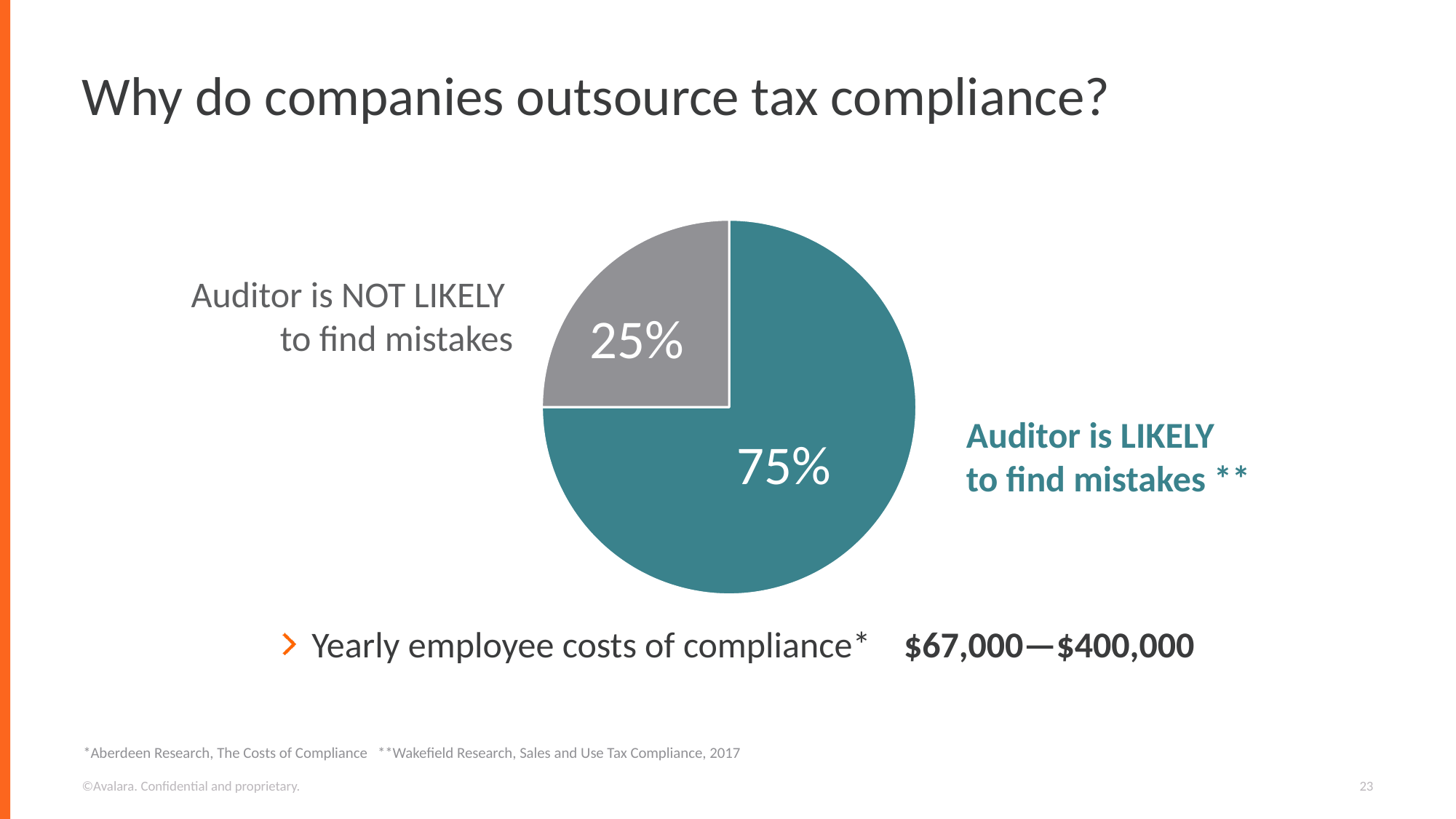
Which slice of the pie is the largest? Auditor is LIKELY to find mistakes What is the difference in percentage points between the 'LIKELY' and 'NOT LIKELY' slices? 50 Is the share for 'Auditor is NOT LIKELY to find mistakes' greater or less than 50%? less What share of the pie is labelled 'Auditor is NOT LIKELY to find mistakes'? 25% What colour is the 'Auditor is NOT LIKELY to find mistakes' slice? grey What share of the pie is labelled 'Auditor is LIKELY to find mistakes'? 75% What kind of chart is shown on the slide? pie chart Which is larger: the 'Auditor is LIKELY to find mistakes' slice or the 'Auditor is NOT LIKELY to find mistakes' slice? Auditor is LIKELY to find mistakes What colour is the 'Auditor is LIKELY to find mistakes' slice? teal Which slice of the pie is the smallest? Auditor is NOT LIKELY to find mistakes How many slices does the pie chart have? 2